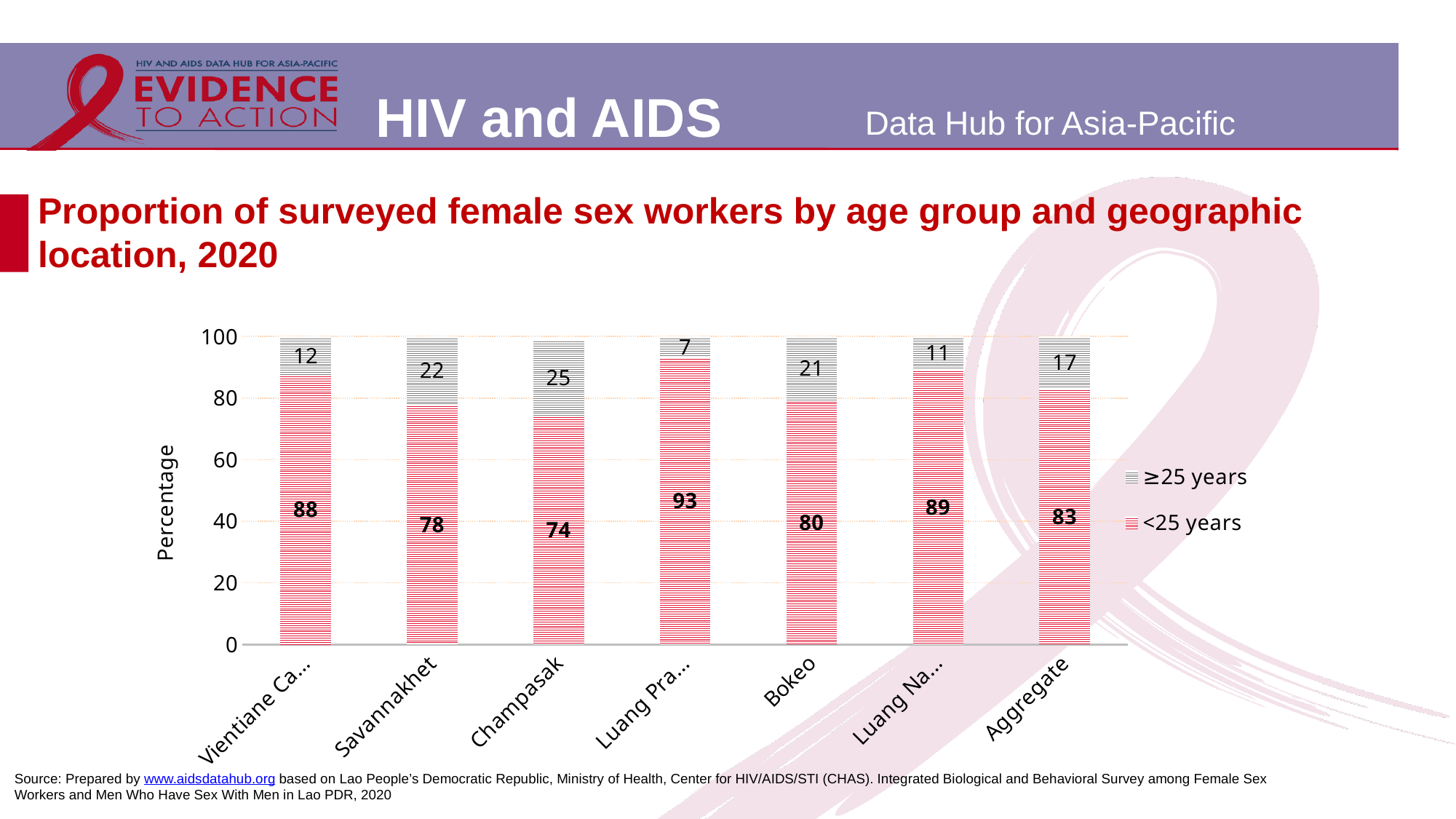
What is the value for <25 years in Bokeo? 80 What is the value for ≥25 years in Champasak? 25 How many categories are shown on the x axis? 7 What kind of chart is shown on the slide? Stacked bar chart Which category has the highest value for ≥25 years? Champasak Which category has the lowest value for <25 years? Champasak Which is larger, the <25 years value for Bokeo or for Savannakhet? Bokeo What is the value for ≥25 years in the Aggregate category? 17 What is the value for <25 years in Savannakhet? 78 What is the difference between the <25 years and ≥25 years values in Savannakhet? 56 What is the total of the stacked bar for Aggregate? 100 How many series does the legend list? 2